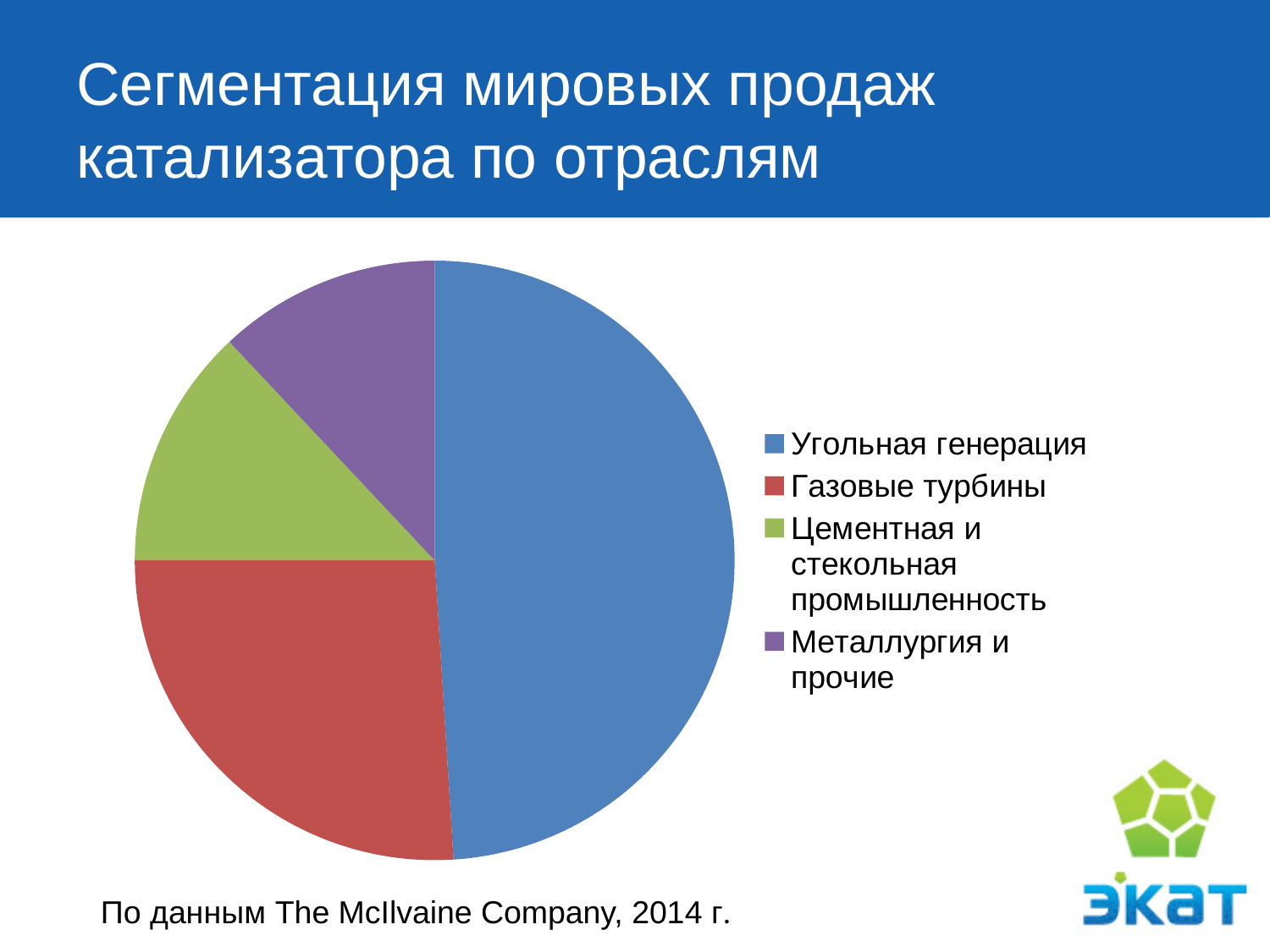
How many entries does the legend of the pie chart list? 4 What kind of chart is shown on the slide? Pie chart How many slices does the pie chart have? 4 Which category is shown in purple in the pie chart? Металлургия и прочие Which category has the largest slice of the pie chart? Угольная генерация What colour is the slice for Газовые турбины? Red Which slice is larger: Газовые турбины or Цементная и стекольная промышленность? Газовые турбины Which slice is larger: Газовые турбины or Металлургия и прочие? Газовые турбины Which category is the second largest slice of the pie chart? Газовые турбины Which slice is larger: Угольная генерация or Газовые турбины? Угольная генерация